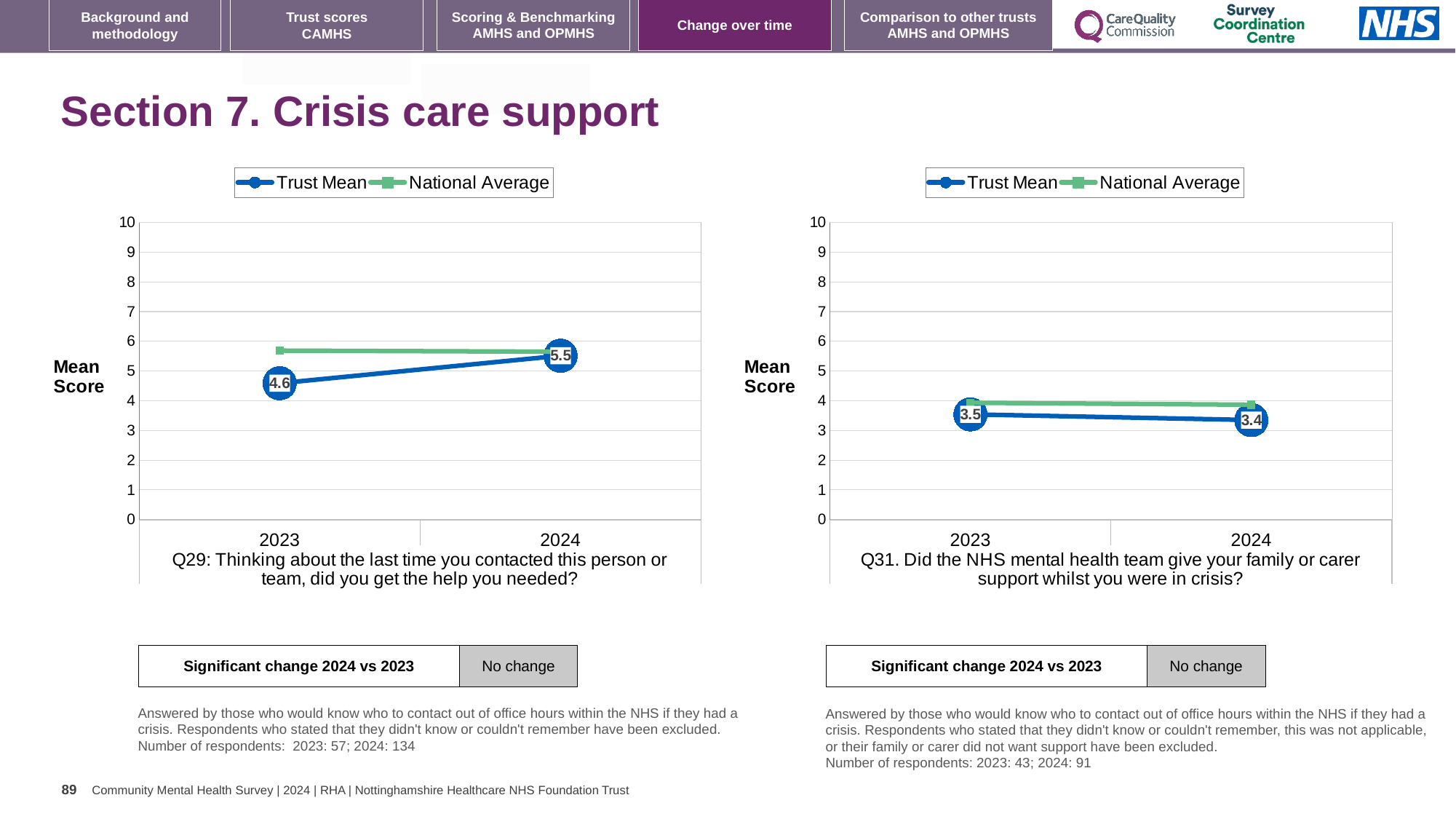
In the left chart (Q29), is the National Average for 2023 greater or less than 5? greater In the left chart (Q29), which is higher in 2023: the Trust Mean or the National Average? National Average In the left chart (Q29), what is the Trust Mean score for 2024? 5.5 In the right chart (Q31), what is the difference between the Trust Mean in 2023 and 2024? 0.1 In the right chart (Q31), what is the Trust Mean score for 2024? 3.4 In the left chart (Q29), by how much did the Trust Mean change from 2023 to 2024? 0.9 What type of chart is used for Q29 on the left? line chart In the left chart (Q29), does the Trust Mean rise or fall from 2023 to 2024? rise In the right chart (Q31), what is the Trust Mean score for 2023? 3.5 In the right chart (Q31), does the Trust Mean rise or fall from 2023 to 2024? fall In the left chart (Q29), what is the Trust Mean score for 2023? 4.6 How many series does the legend of the right chart (Q31) list? 2